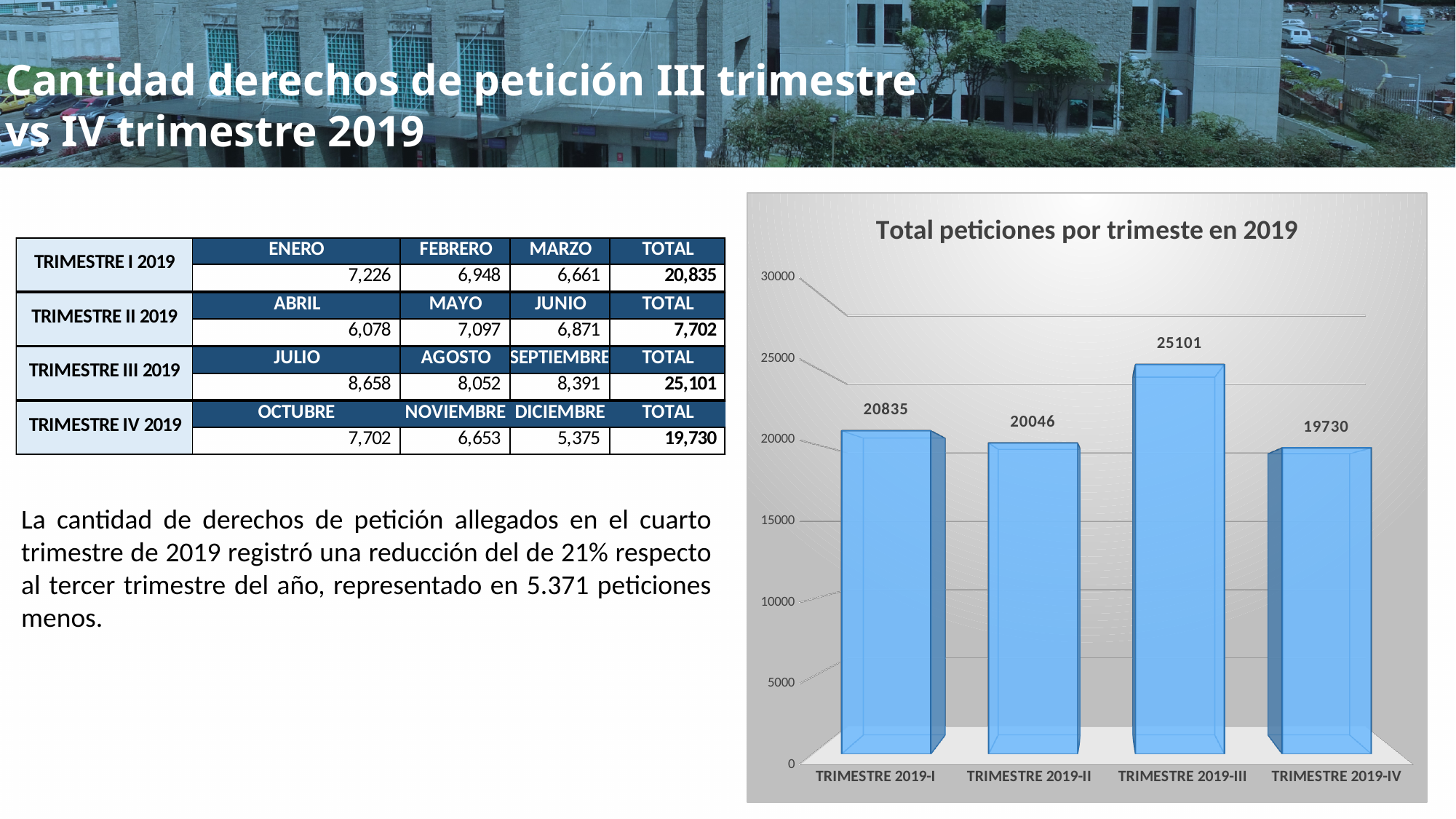
What is the value for TRIMESTRE 2019-I in the chart? 20835 Which quarter has the lowest total in the chart? TRIMESTRE 2019-IV What is the value for TRIMESTRE 2019-III in the chart? 25101 How many quarters are shown in the chart? 4 What is the title of the chart? Total peticiones por trimeste en 2019 What kind of chart is shown on the slide? bar chart Which is larger, the value for TRIMESTRE 2019-I or TRIMESTRE 2019-II? TRIMESTRE 2019-I What is the difference between the values for TRIMESTRE 2019-I and TRIMESTRE 2019-II? 789 Is the value for TRIMESTRE 2019-III greater or less than 20000? greater Which quarter has the highest total in the chart? TRIMESTRE 2019-III What is the value for TRIMESTRE 2019-IV in the chart? 19730 What is the difference between the values for TRIMESTRE 2019-III and TRIMESTRE 2019-IV? 5371